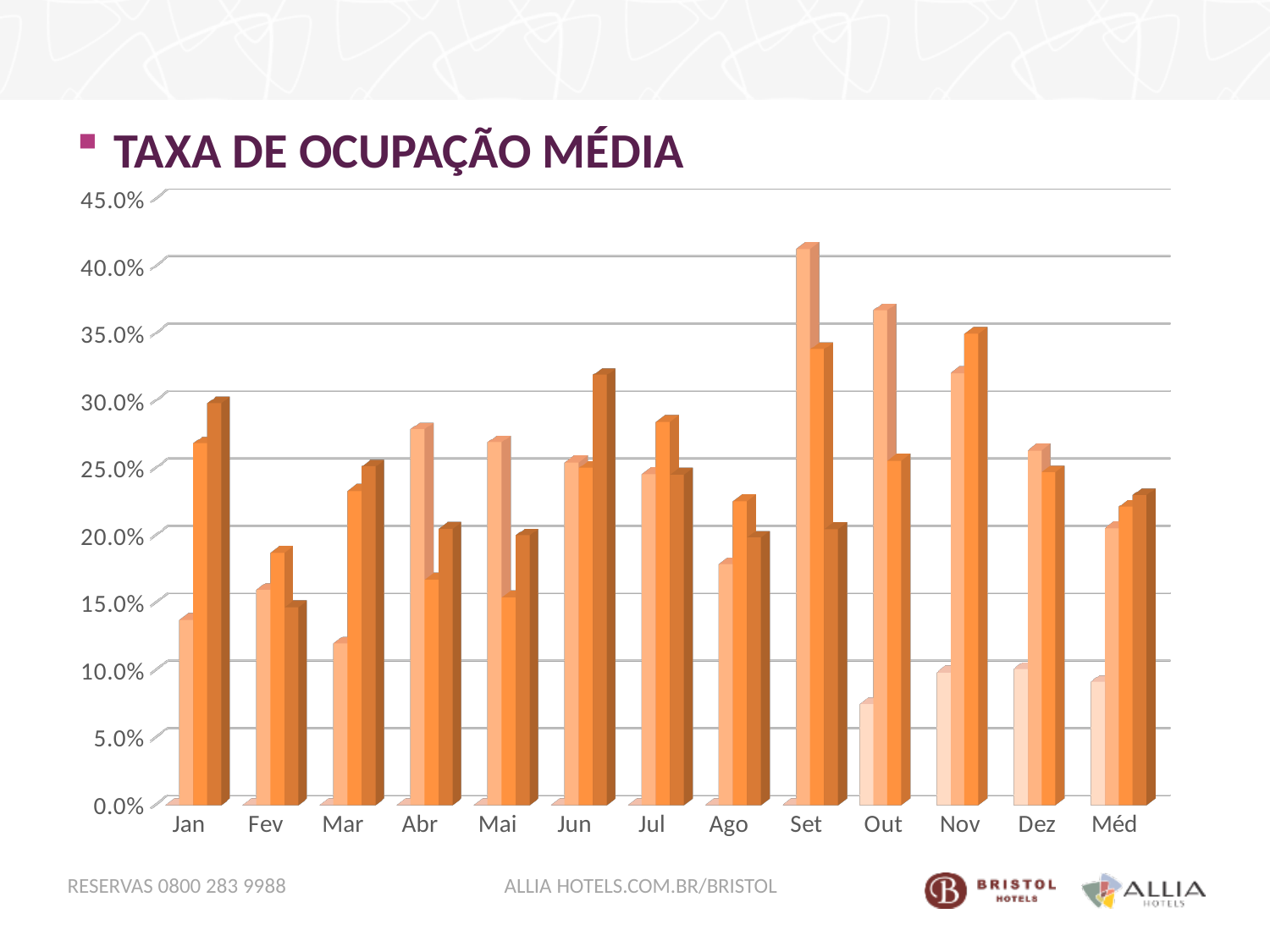
Is the leftmost bar for Out greater or less than 10.0%? less How many categories are shown along the x axis of the chart? 13 Which is larger: the rightmost bar for Jan or the rightmost bar for Fev? Jan What kind of chart is shown on the slide? bar chart Which category contains the tallest bar in the chart? Set Is the leftmost bar for Jan greater or less than 15.0%? less Is the rightmost bar for Jun greater or less than 30.0%? greater Which category contains the shortest bar in the chart? Out What is the title of the chart? TAXA DE OCUPAÇÃO MÉDIA Which is larger: the leftmost bar for Abr or the leftmost bar for Mar? Abr